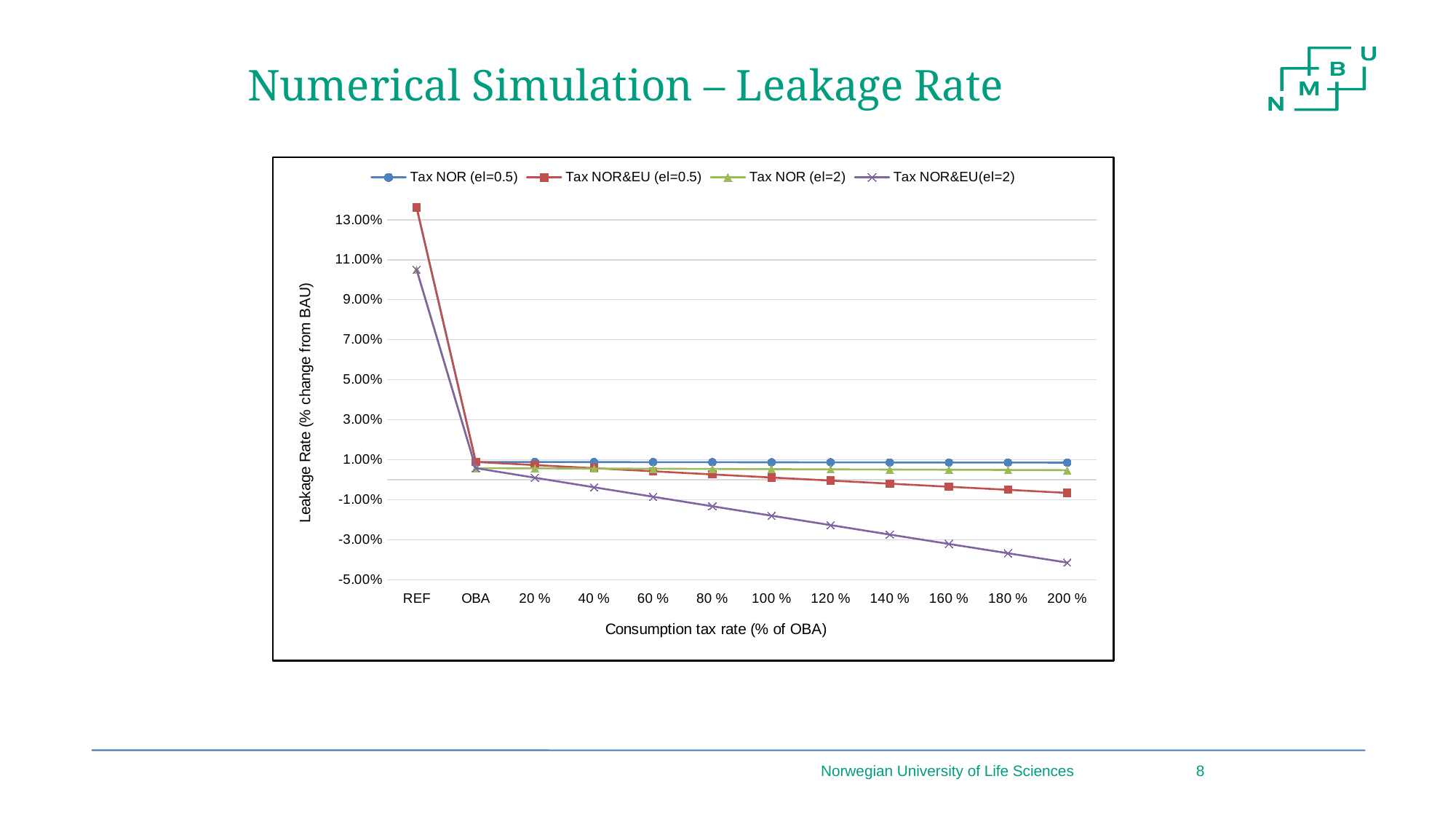
Is the value for Tax NOR&EU (el=0.5) at REF greater or less than 11.00%? greater Is the value for Tax NOR&EU(el=2) at 200 % greater or less than -3.00%? less Does the Tax NOR&EU(el=2) series rise or fall from OBA to 200 %? fall Which series has the lowest value at 200 %? Tax NOR&EU(el=2) Is the value for Tax NOR&EU(el=2) at REF greater or less than 9.00%? greater What kind of chart is shown on the slide? line chart How many categories are shown along the x axis? 12 At 200 %, which is larger: Tax NOR (el=0.5) or Tax NOR&EU(el=2)? Tax NOR (el=0.5) What is the title of the x axis? Consumption tax rate (% of OBA) How many series does the legend list? 4